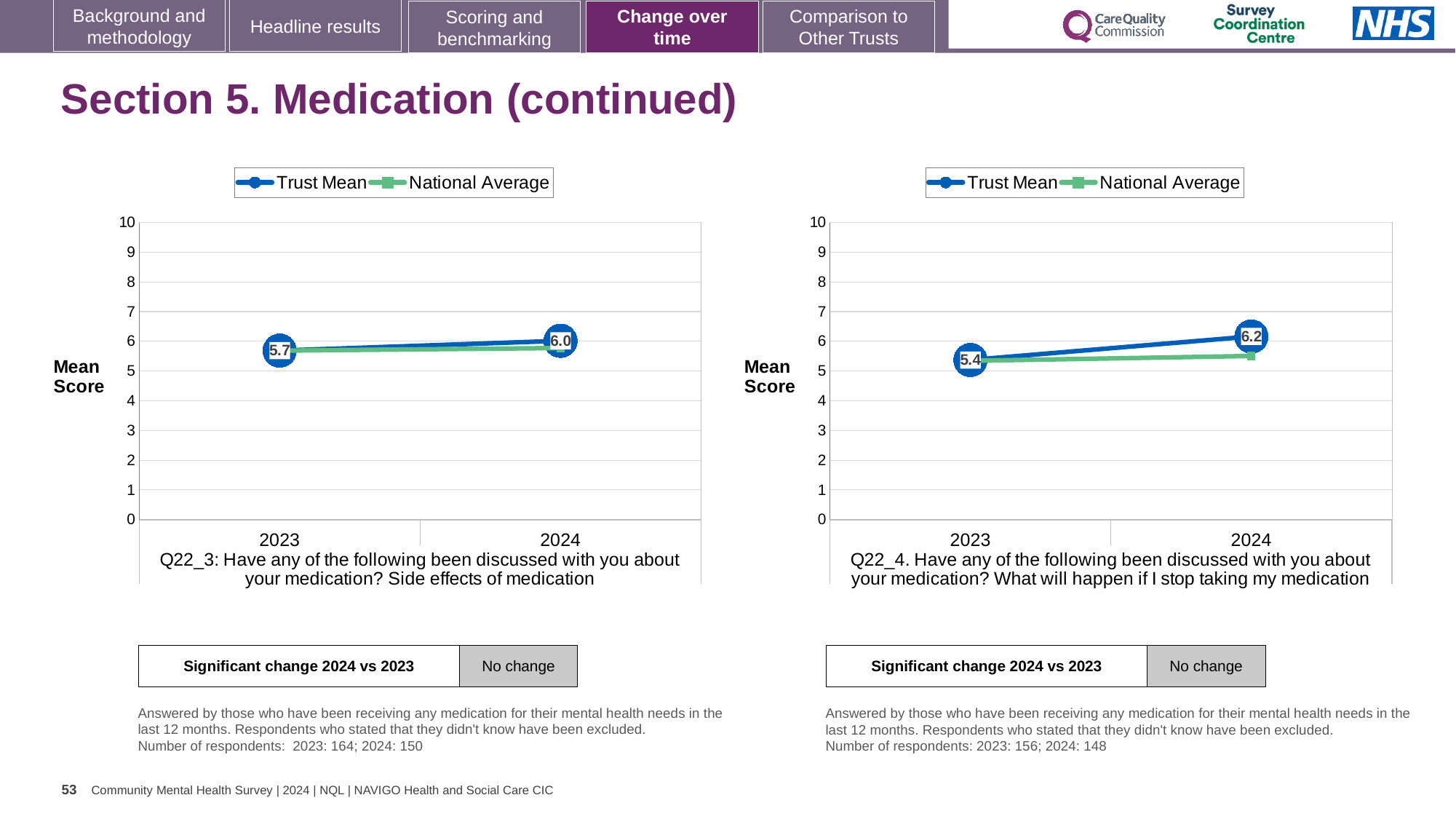
How many series does the legend of the left chart list? 2 In the left chart (Q22_3), what is the Trust Mean score for 2024? 6.0 In the right chart (Q22_4), by how much did the Trust Mean change from 2023 to 2024? 0.8 In the right chart (Q22_4), is the National Average value for 2024 greater or less than 5? greater In the right chart (Q22_4), what is the Trust Mean score for 2024? 6.2 In the left chart (Q22_3), what is the difference between the Trust Mean for 2024 and 2023? 0.3 In the right chart (Q22_4), what is the Trust Mean score for 2023? 5.4 How many years are plotted on the x axis of the left chart (Q22_3)? 2 In the left chart (Q22_3), does the Trust Mean rise or fall from 2023 to 2024? rise In the left chart (Q22_3), what is the Trust Mean score for 2023? 5.7 In the right chart (Q22_4), which year has the higher Trust Mean, 2023 or 2024? 2024 What kind of chart is the right chart (Q22_4)? line chart